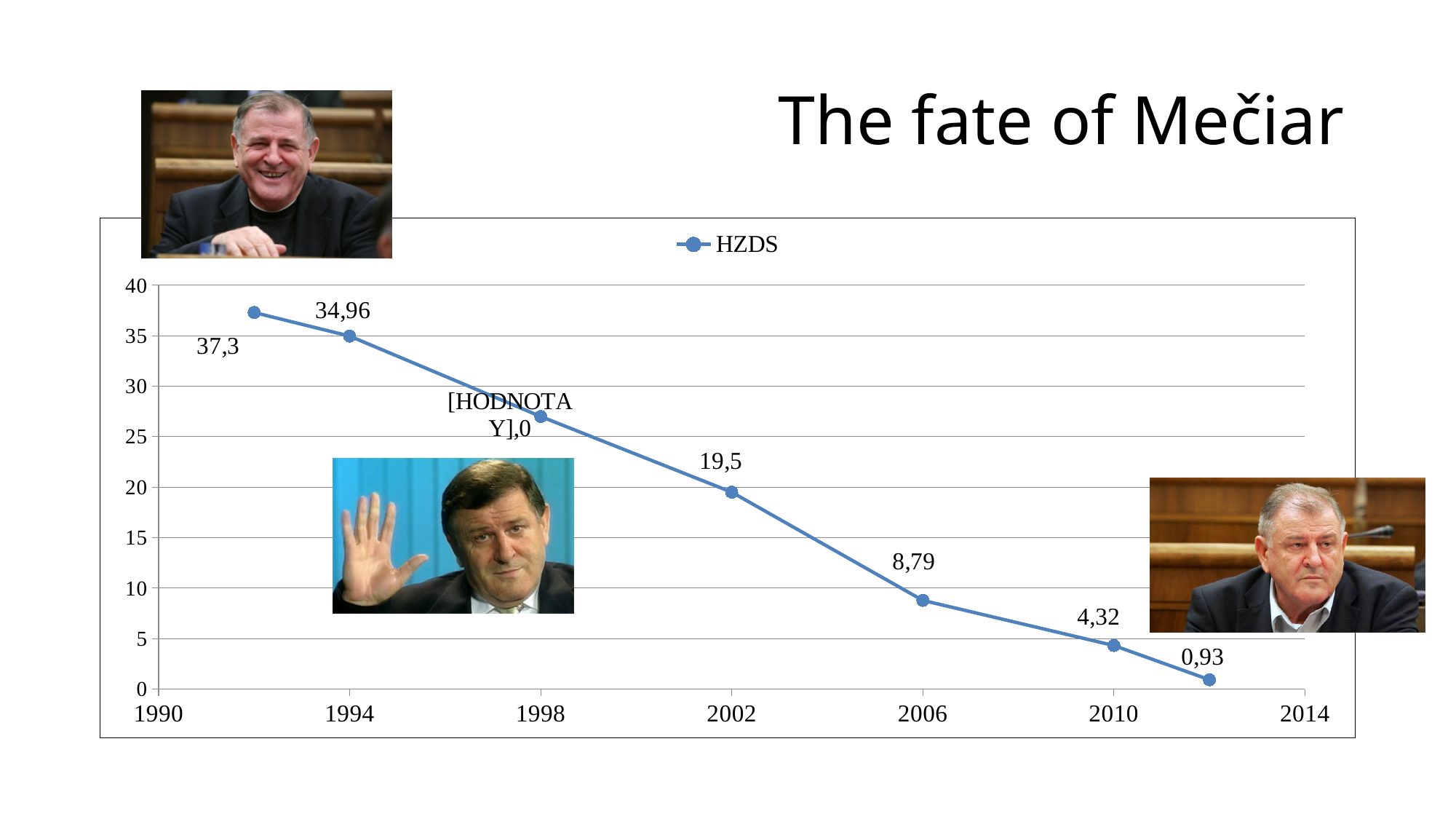
What is the HZDS value for 2006? 8,79 Is the HZDS value for 1998 greater or less than 25? greater Do the HZDS values rise or fall along the x axis? fall What is the HZDS value for 1994? 34,96 What is the difference between the HZDS values for 2002 and 2006? 10,71 How many series does the legend list? 1 What is the name of the series shown in the legend? HZDS What kind of chart is shown on the slide? line chart What is the value of the leftmost (first) data point on the line? 37,3 What is the HZDS value for 2002? 19,5 What is the value of the rightmost (last) data point on the line? 0,93 What is the HZDS value for 2010? 4,32